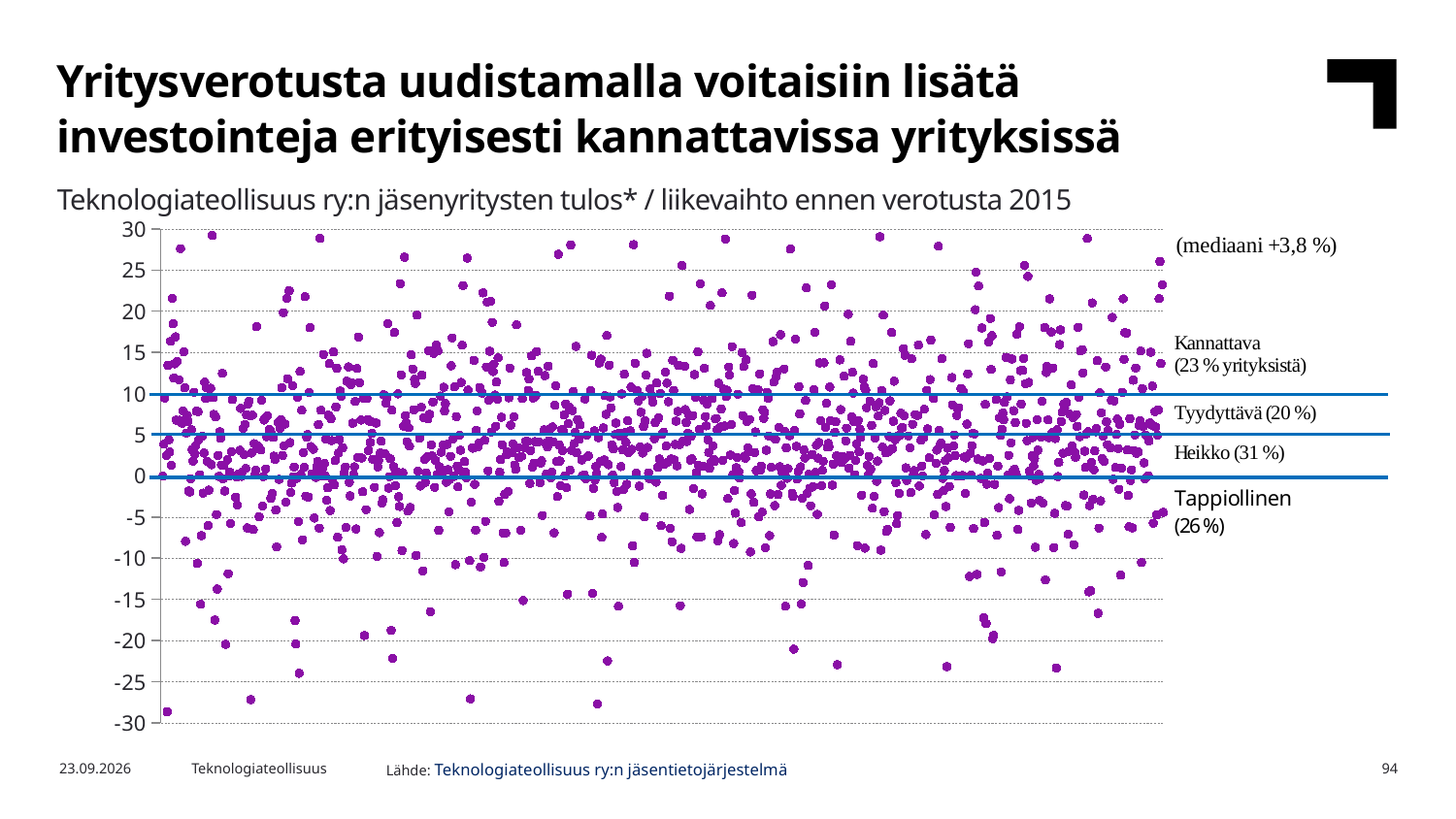
What is the median value of tulos / liikevaihto shown on the chart? +3,8 % What share of companies is labelled Tyydyttävä on the chart? 20 % Which of the four profitability groups has the smallest share of companies? Tyydyttävä Which group has a larger share of companies, Kannattava or Tappiollinen? Tappiollinen Which of the four profitability groups has the largest share of companies? Heikko What share of companies is labelled Kannattava on the chart? 23 % What is the subtitle of the chart? Teknologiateollisuus ry:n jäsenyritysten tulos* / liikevaihto ennen verotusta 2015 What kind of chart is shown on the slide? scatter chart What is the difference in percentage points between the Heikko share and the Tappiollinen share? 5 What share of companies is labelled Heikko on the chart? 31 % What are the highest and lowest values shown on the vertical axis? 30 and -30 What share of companies is labelled Tappiollinen on the chart? 26 %